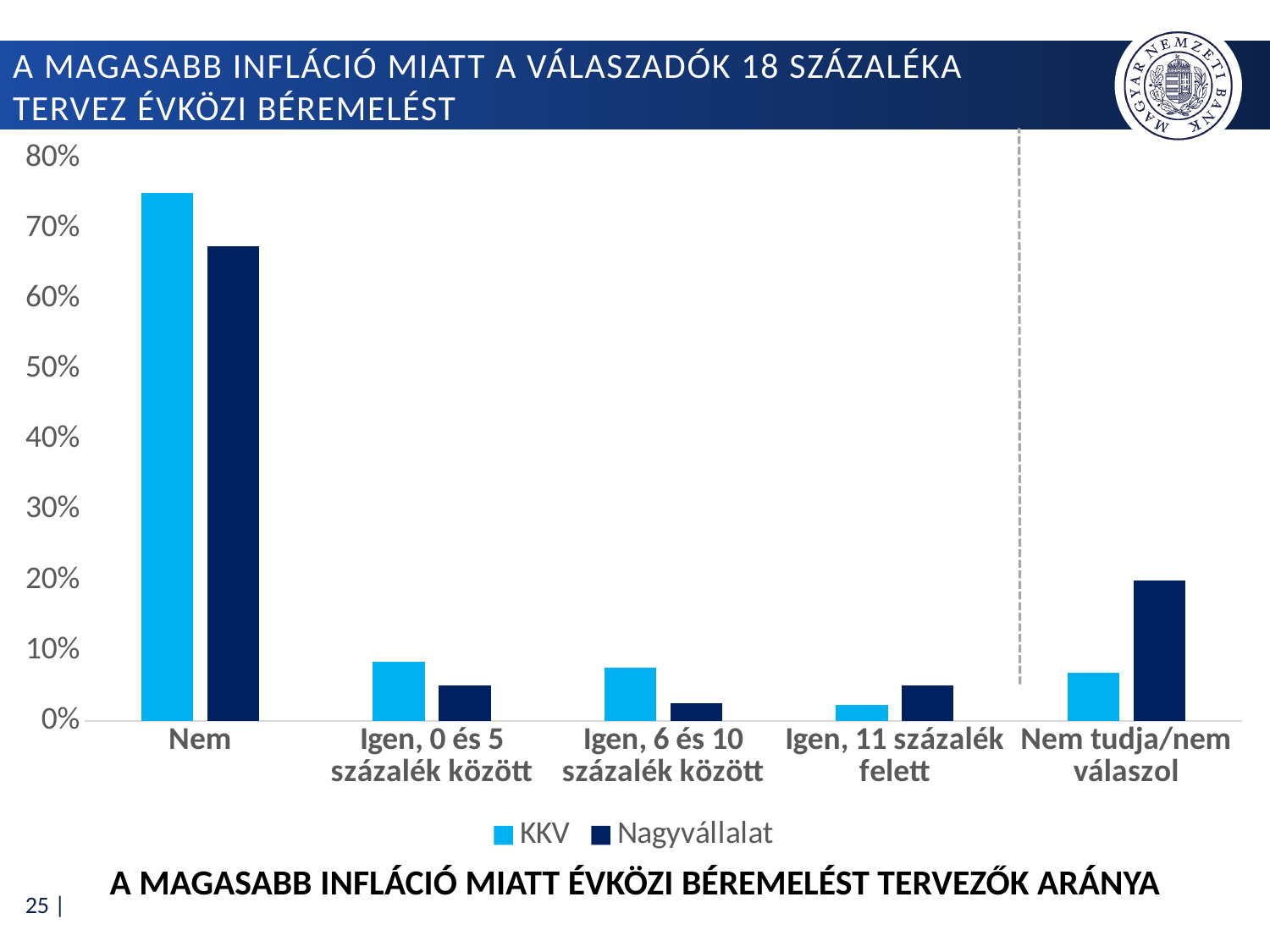
Which category has the highest value for the Nagyvállalat series? Nem Is the Nagyvállalat value for Nem tudja/nem válaszol greater or less than 10%? greater How many series does the legend list? 2 For the category Nem tudja/nem válaszol, which series has the larger value, KKV or Nagyvállalat? Nagyvállalat What kind of chart is shown on the slide? bar chart Which series are listed in the legend? KKV and Nagyvállalat Which category has the lowest value for the Nagyvállalat series? Igen, 6 és 10 százalék között How many categories are shown on the x axis of the chart? 5 Is the KKV value for Nem greater or less than 70%? greater For the category Nem, which series has the larger value, KKV or Nagyvállalat? KKV Which category has the lowest value for the KKV series? Igen, 11 százalék felett Which category has the highest value for the KKV series? Nem